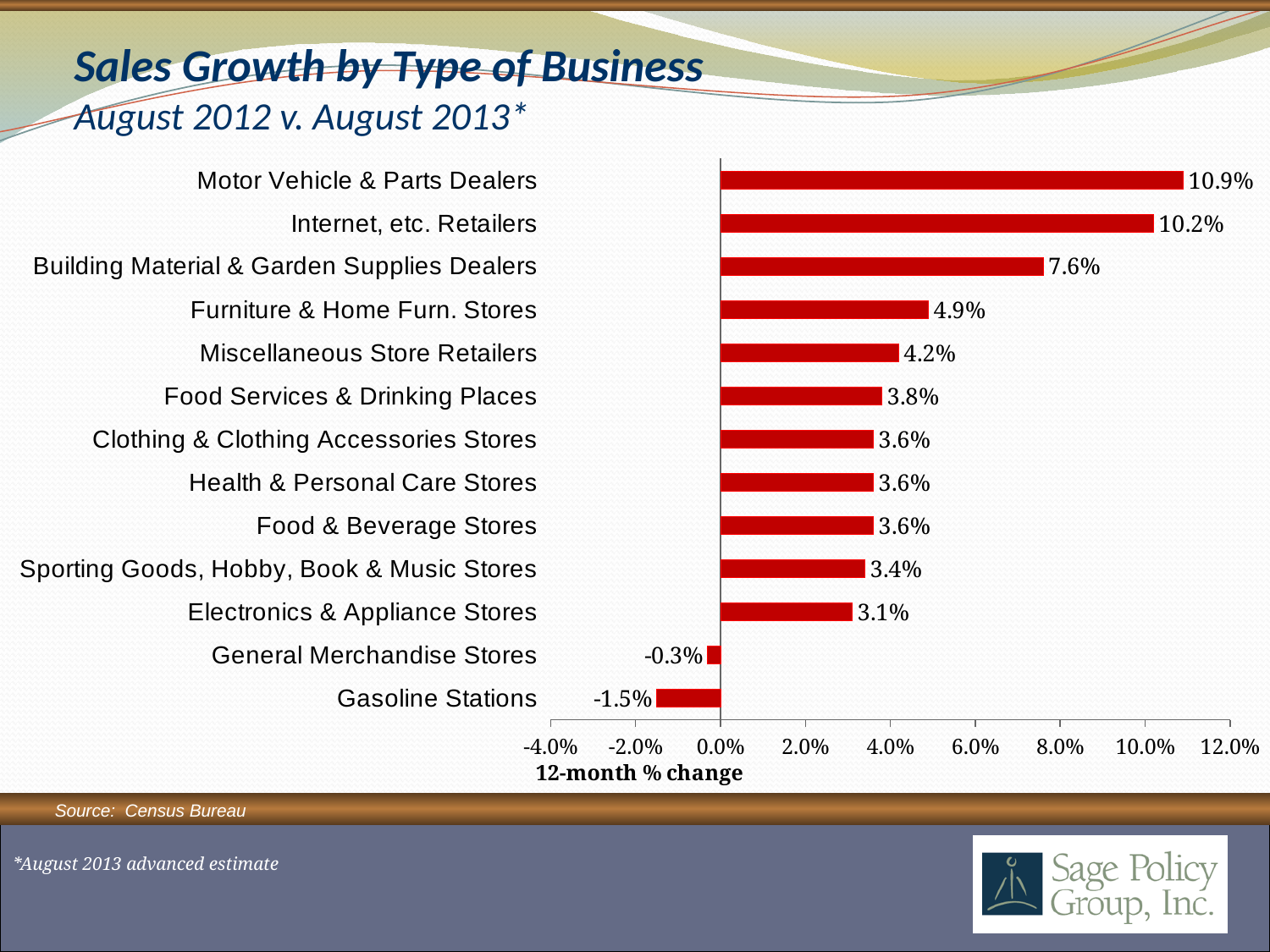
Is the value for Building Material & Garden Supplies Dealers greater or less than 6.0%? greater What is the 12-month % change for Building Material & Garden Supplies Dealers? 7.6% What is the difference between the sales growth of Internet, etc. Retailers and Electronics & Appliance Stores? 7.1% What is the label on the horizontal axis of the chart? 12-month % change What kind of chart is shown on the slide? Bar chart What is the 12-month % change for Gasoline Stations? -1.5% How many types of business are shown in the chart? 13 How many types of business show a negative 12-month % change? 2 Which type of business has the highest sales growth? Motor Vehicle & Parts Dealers Which type of business has the lowest sales growth? Gasoline Stations What is the 12-month % change for Motor Vehicle & Parts Dealers? 10.9% Which has higher sales growth, Furniture & Home Furn. Stores or Miscellaneous Store Retailers? Furniture & Home Furn. Stores